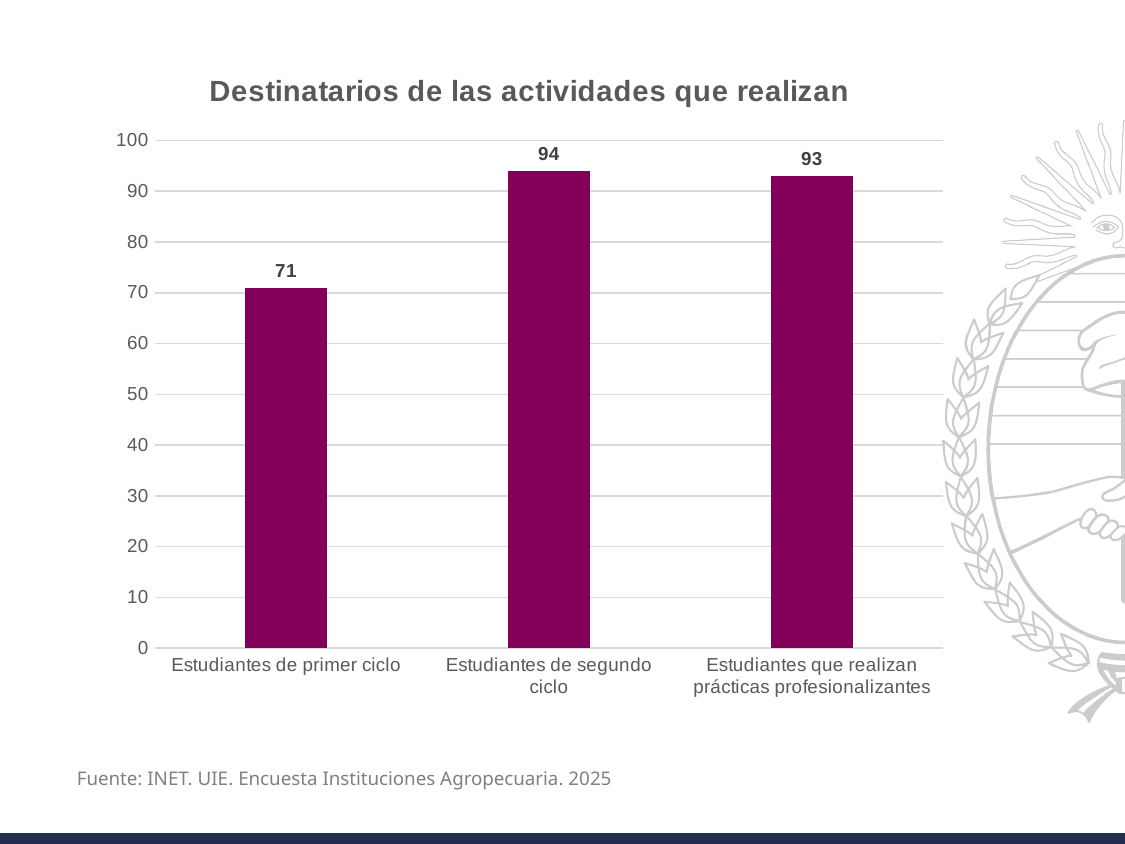
Which is larger: the value for Estudiantes de primer ciclo or the value for Estudiantes que realizan prácticas profesionalizantes? Estudiantes que realizan prácticas profesionalizantes Which category has the lowest value? Estudiantes de primer ciclo What is the difference between the values for Estudiantes que realizan prácticas profesionalizantes and Estudiantes de primer ciclo? 22 What is the value for Estudiantes de primer ciclo? 71 Which category has the highest value? Estudiantes de segundo ciclo What is the difference between the values for Estudiantes de segundo ciclo and Estudiantes de primer ciclo? 23 What is the value for Estudiantes de segundo ciclo? 94 Is the value for Estudiantes de primer ciclo greater or less than 80? less What is the title of the chart? Destinatarios de las actividades que realizan What is the value for Estudiantes que realizan prácticas profesionalizantes? 93 How many categories are shown in the chart? 3 What kind of chart is shown on the slide? bar chart